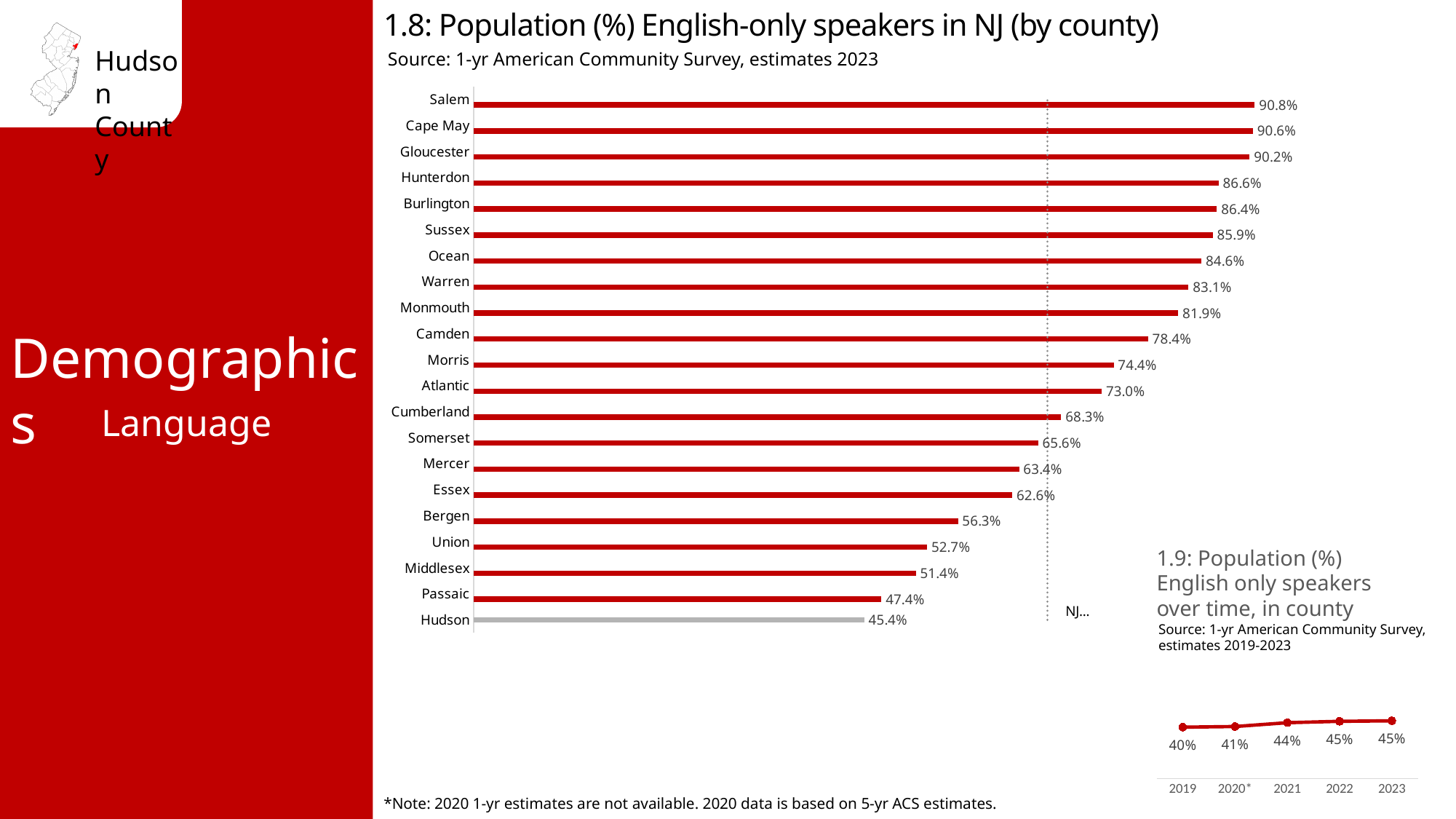
In chart 1.8, how many counties are shown? 21 In chart 1.8, which is larger, the value for Passaic or the value for Middlesex? Middlesex In chart 1.8, what is the value for Hudson? 45.4% What kind of chart is chart 1.9? line chart In chart 1.9, what is the value for 2019? 40% In chart 1.9, do the values rise or fall from 2019 to 2023? rise In chart 1.8, which county has the lowest percentage of English-only speakers? Hudson In chart 1.8, what is the difference between the values for Salem and Hudson? 45.4 percentage points In chart 1.8, which county has the highest percentage of English-only speakers? Salem In chart 1.9, what is the value for 2023? 45% In chart 1.8, what is the value for Bergen? 56.3% What kind of chart is chart 1.8? bar chart